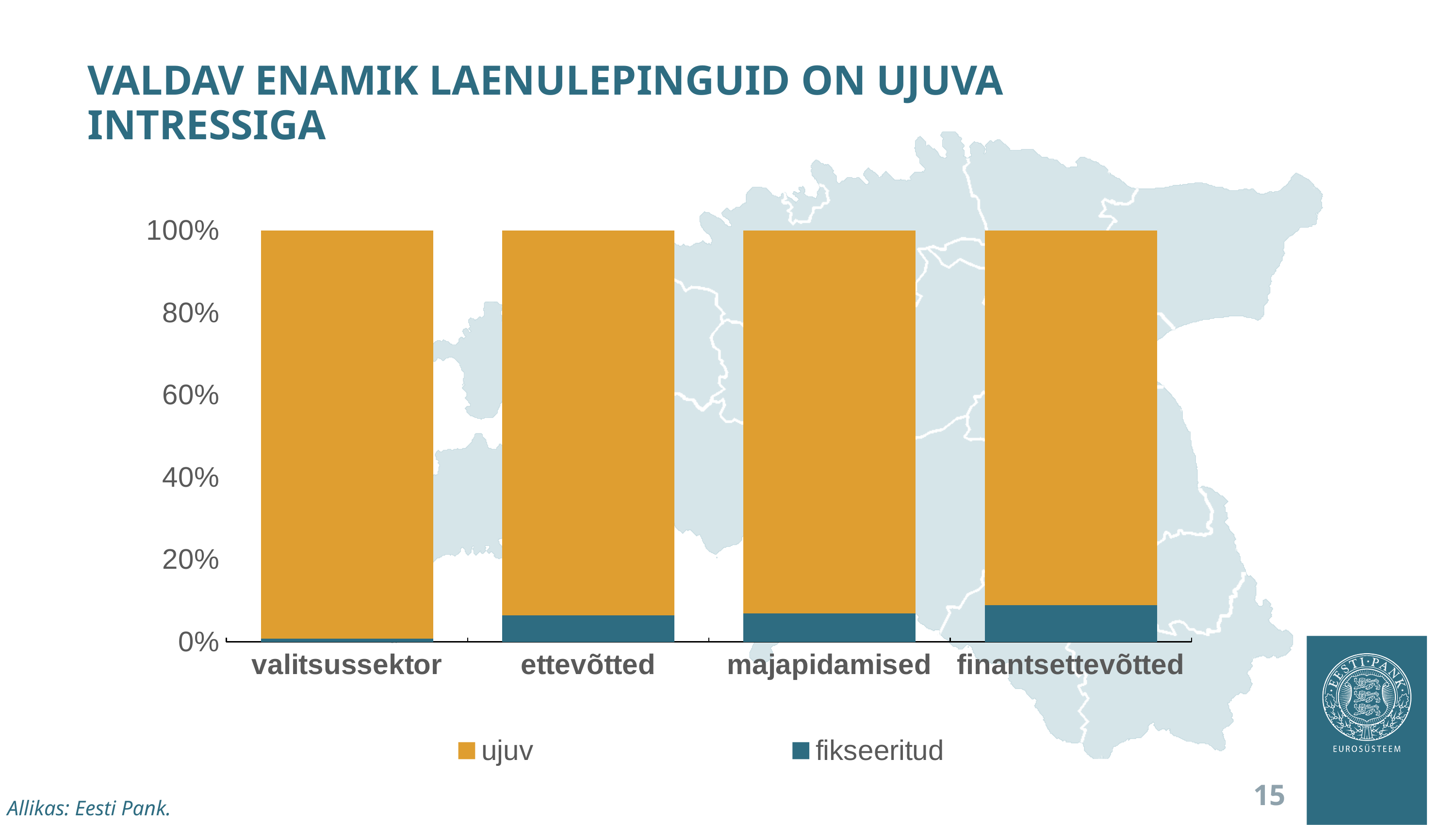
What is the total height of the stacked bar for ettevõtted? 100% How many series does the chart's legend list? 2 Which series is shown in orange in the chart? ujuv Which category has the largest ujuv share? valitsussektor How many categories are shown on the x axis of the chart? 4 What kind of chart is shown on the slide? stacked bar chart Is the ujuv share for majapidamised greater or less than 80%? greater What is the source cited for the chart? Eesti Pank Which category has the smallest fikseeritud share? valitsussektor Is the fikseeritud share larger for valitsussektor or for finantsettevõtted? finantsettevõtted Which category has the largest fikseeritud share? finantsettevõtted Is the fikseeritud share for ettevõtted greater or less than 20%? less